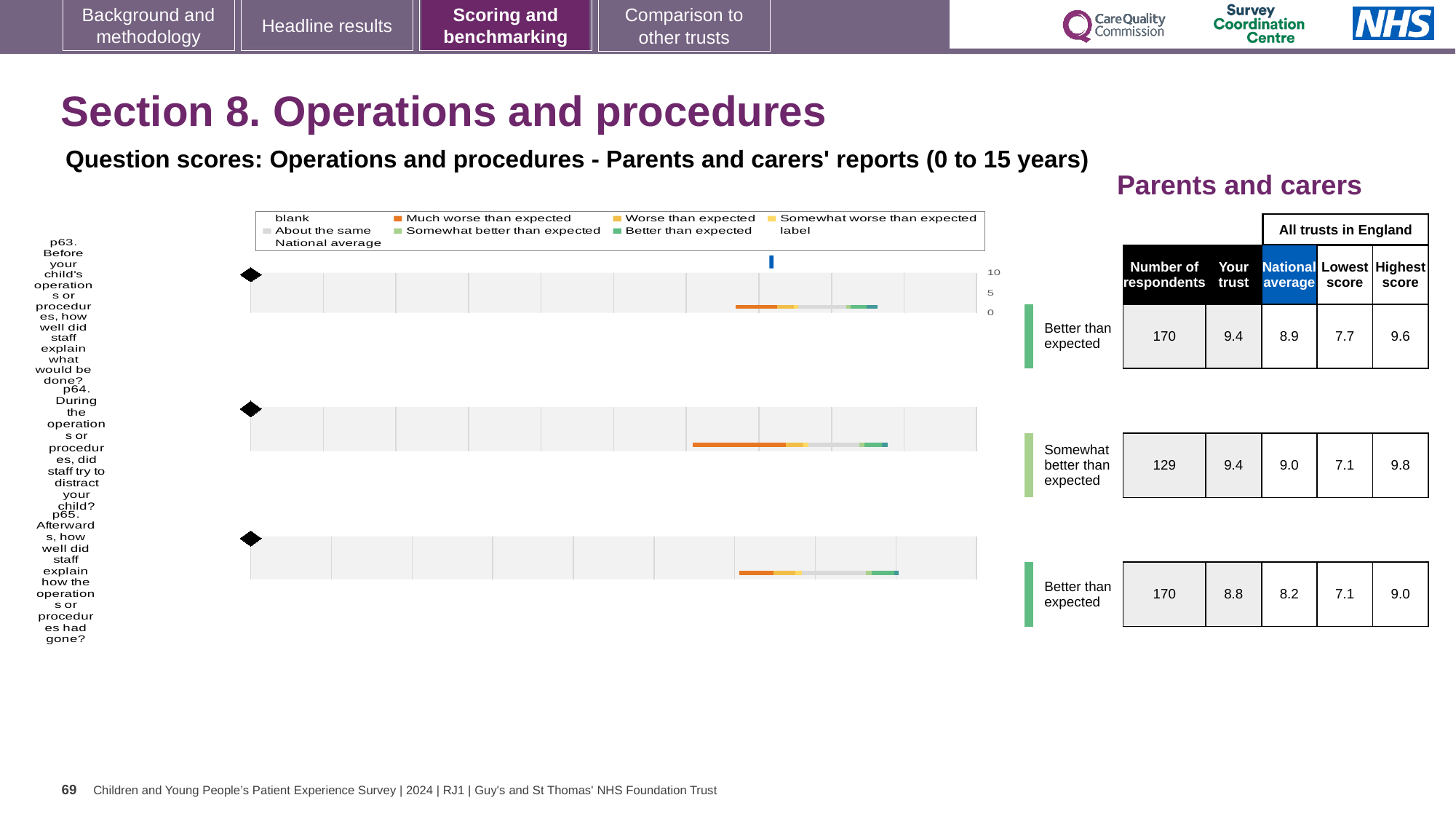
What is the 'Your trust' score for p63 (how well staff explained what would be done before the operation)? 9.4 For p64, which is larger: the 'Your trust' score or the national average? Your trust What is the difference between the 'Your trust' score and the national average for p65? 0.6 Which question has the lowest 'Your trust' score? p65 What benchmark category is shown for p64? Somewhat better than expected How many questions (categories) are plotted in the Operations and procedures chart? 3 What is the national average score for p64 (did staff try to distract your child during the operation)? 9.0 What kind of chart is used to show the question scores for Operations and procedures? bar chart What is the 'Your trust' score for p65 (how well staff explained how the operation had gone)? 8.8 What is the highest score among all trusts in England for p63? 9.6 How many respondents answered question p64? 129 Which question has the highest national average score? p64